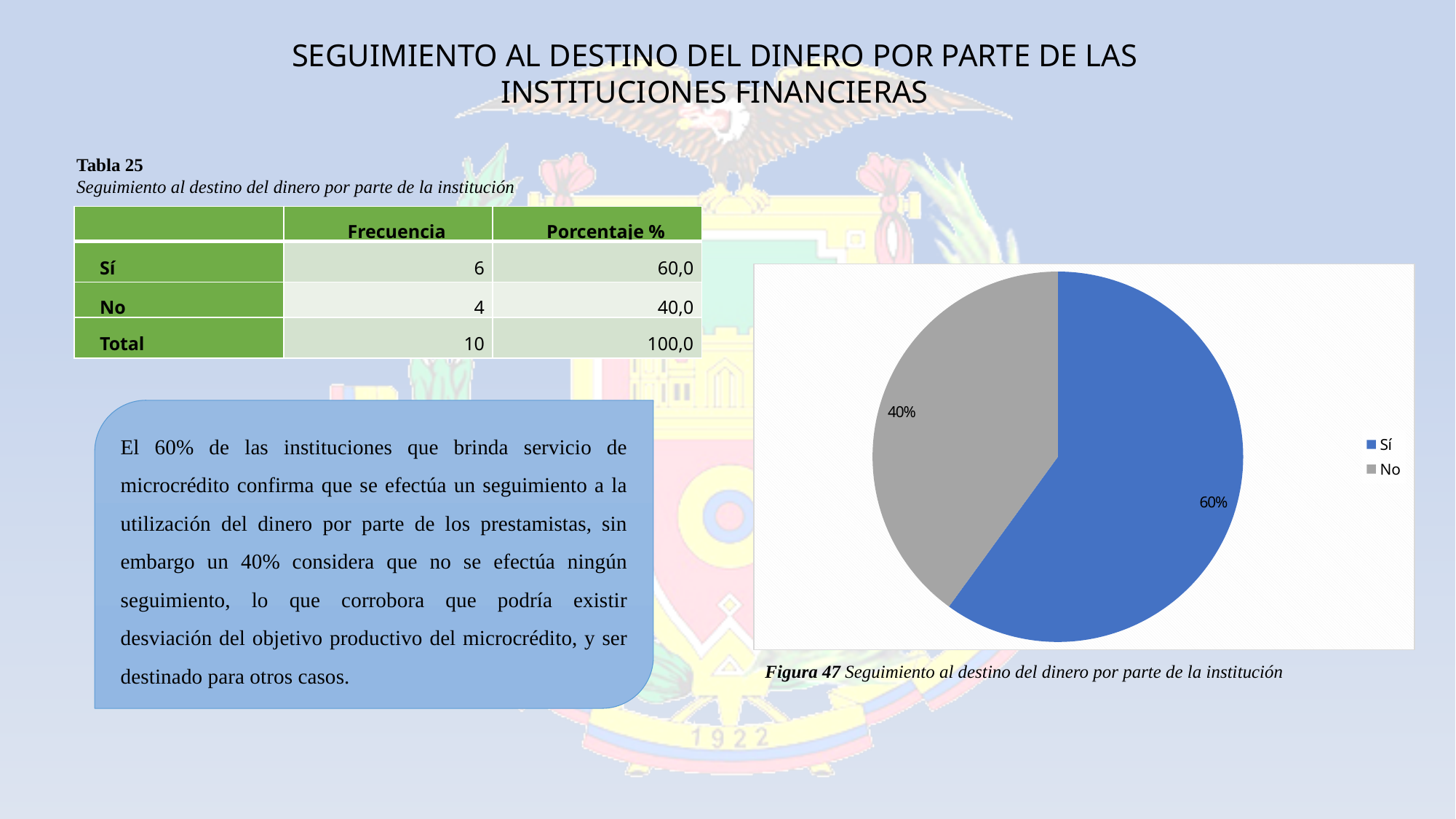
What type of chart is shown on the slide? pie chart What is the difference in percentage points between the 'Sí' and 'No' slices of the pie chart? 20% What colour is the 'Sí' slice in the pie chart? blue Which slice of the pie chart is the smallest? No How many entries does the legend of the pie chart list? 2 What percentage does the 'Sí' slice of the pie chart show? 60% What percentage does the 'No' slice of the pie chart show? 40% Which slice of the pie chart is the largest? Sí Which is larger in the pie chart, 'Sí' or 'No'? Sí What colour is the 'No' slice in the pie chart? grey How many slices does the pie chart have? 2 What share of the pie does the 'No' slice represent? 40%